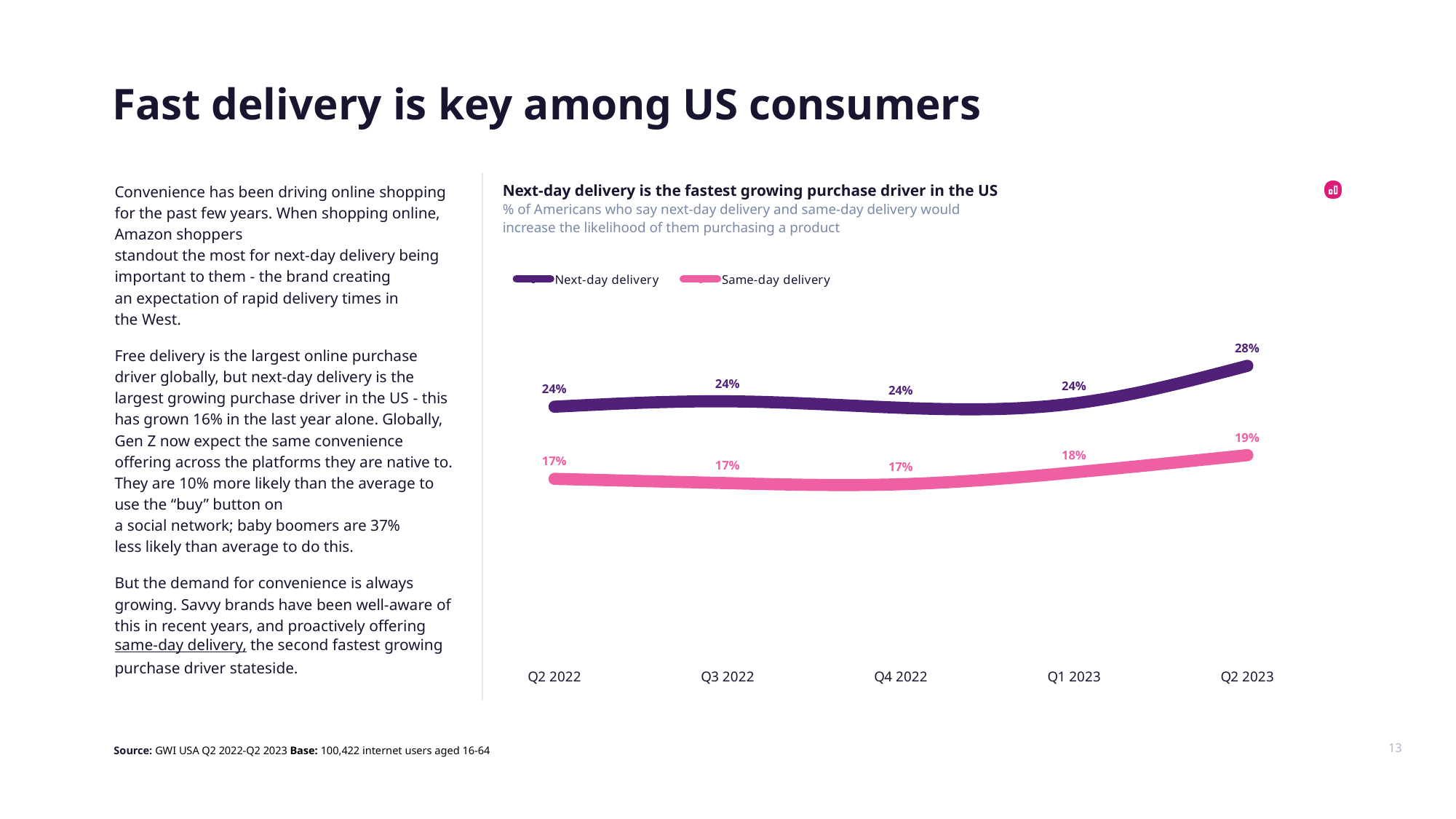
How many series does the legend list? 2 What is the title of the chart? Next-day delivery is the fastest growing purchase driver in the US What is the value for Same-day delivery in Q2 2022? 17% What is the value for Same-day delivery in Q1 2023? 18% What is the value for Next-day delivery in Q2 2023? 28% In which quarter is the Next-day delivery value highest? Q2 2023 Which series has the larger value in Q3 2022, Next-day delivery or Same-day delivery? Next-day delivery What is the value for Next-day delivery in Q4 2022? 24% By how much did the Same-day delivery value change from Q2 2022 to Q2 2023? 2 percentage points What kind of chart is shown on the slide? Line chart How many quarters are shown on the x axis? 5 What is the difference between Next-day delivery and Same-day delivery in Q2 2023? 9 percentage points